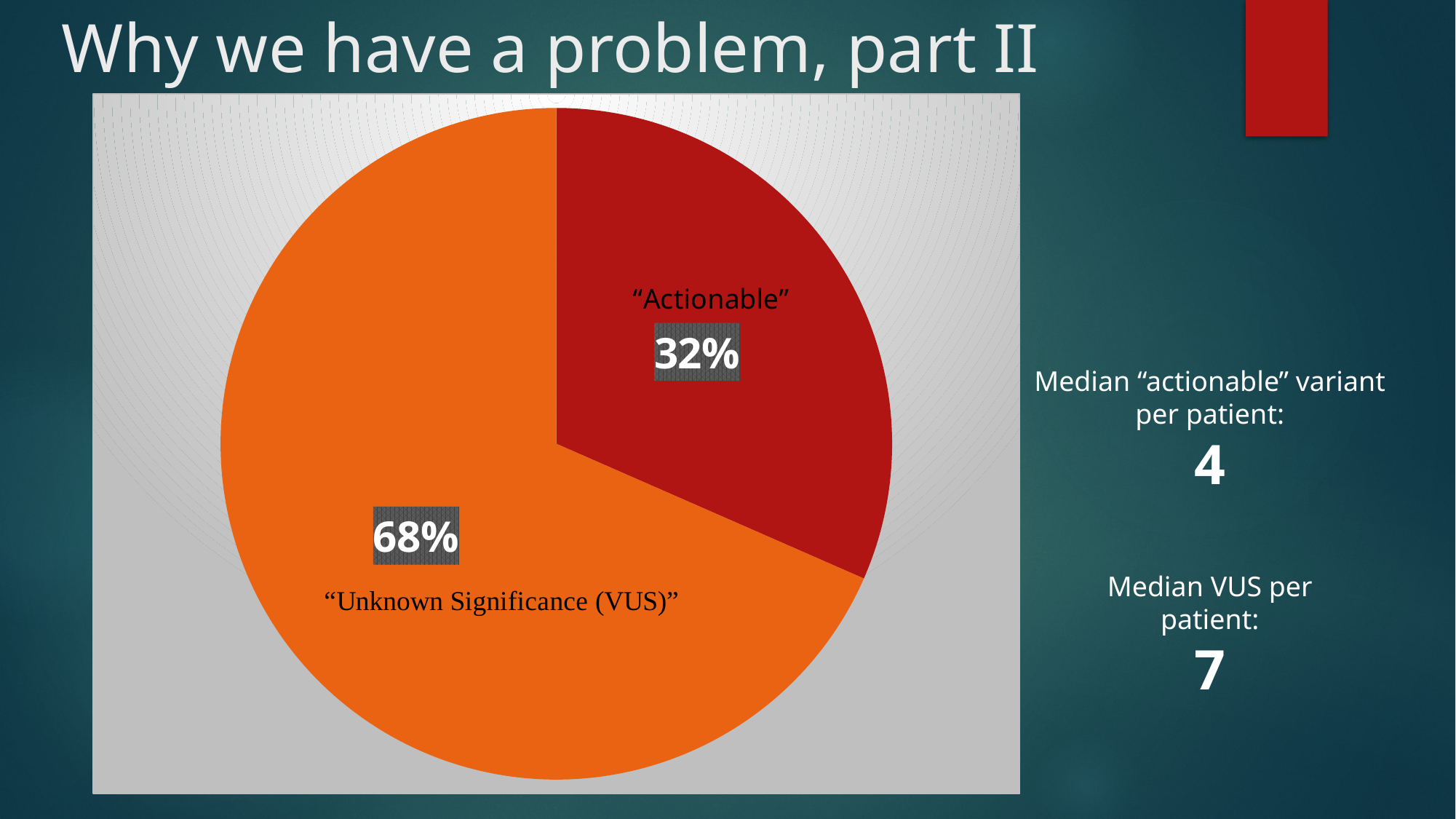
Which slice of the pie is the largest? "Unknown Significance (VUS)" What share of the pie is labelled "Actionable"? 32% What is the difference in percentage points between the "Unknown Significance (VUS)" slice and the "Actionable" slice? 36 Which slice of the pie is the smallest? "Actionable" What colour is the "Actionable" slice of the pie? Red How many slices does the pie chart have? 2 Is the share of the "Actionable" slice greater or less than 50%? less Which is larger, the "Actionable" slice or the "Unknown Significance (VUS)" slice? "Unknown Significance (VUS)" What do the two slices of the pie add up to? 100% What kind of chart is shown on the slide? Pie chart What share of the pie is labelled "Unknown Significance (VUS)"? 68% What colour is the "Unknown Significance (VUS)" slice of the pie? Orange